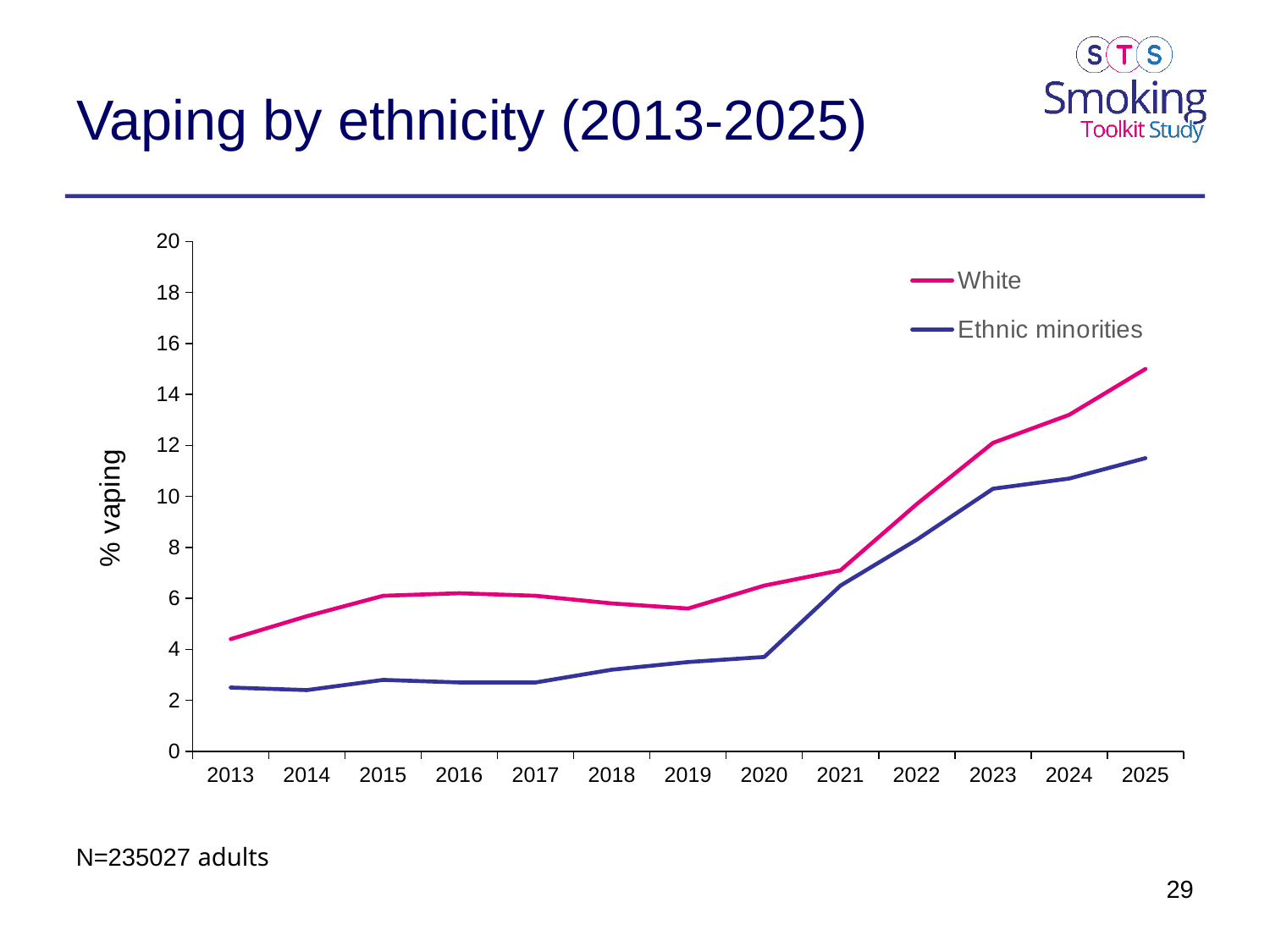
Is the value for Ethnic minorities in 2013 greater or less than 4? less In 2025, which series has the higher value, White or Ethnic minorities? White In which year is the White series at its lowest? 2013 Is the value for White in 2025 greater or less than 14? greater Does the Ethnic minorities series rise or fall between 2020 and 2025? Rise How many years are labelled on the x axis? 13 In which year is the White series at its highest? 2025 Is the value for White in 2013 greater or less than 6? less What kind of chart is shown on the slide? Line chart How many series does the legend list? 2 What is the label on the y axis? % vaping